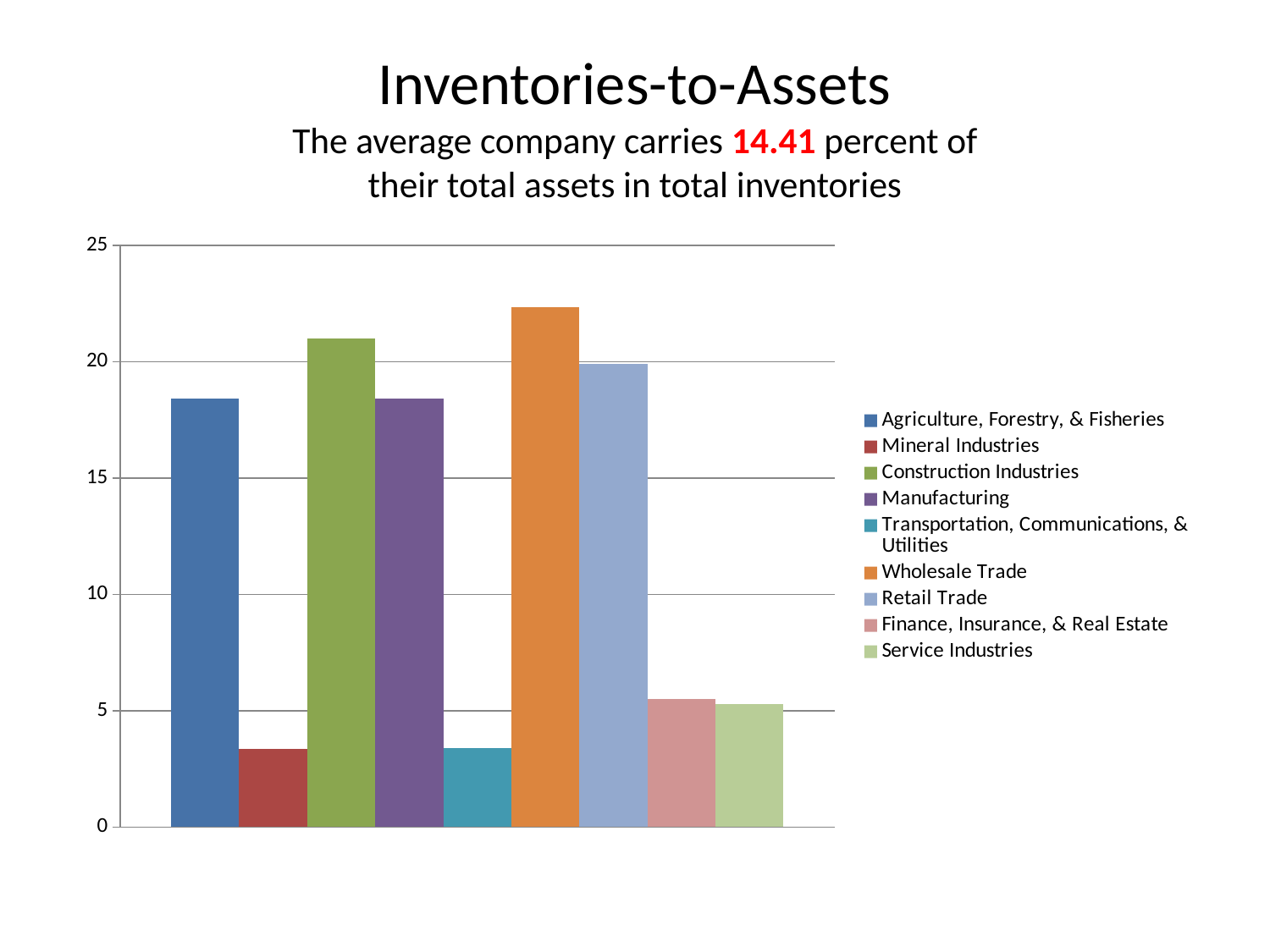
Is the value for Construction Industries greater or less than 20? greater Which industry has the highest inventories-to-assets value? Wholesale Trade Is the value for Wholesale Trade greater or less than 20? greater What is the title of the slide? Inventories-to-Assets Is the value for Service Industries greater or less than 10? less According to the slide subtitle, what percent of total assets does the average company carry in total inventories? 14.41 Which is larger, the value for Construction Industries or the value for Manufacturing? Construction Industries How many series does the legend list? 9 Which is larger, the value for Wholesale Trade or the value for Retail Trade? Wholesale Trade What kind of chart is shown on the slide? bar chart